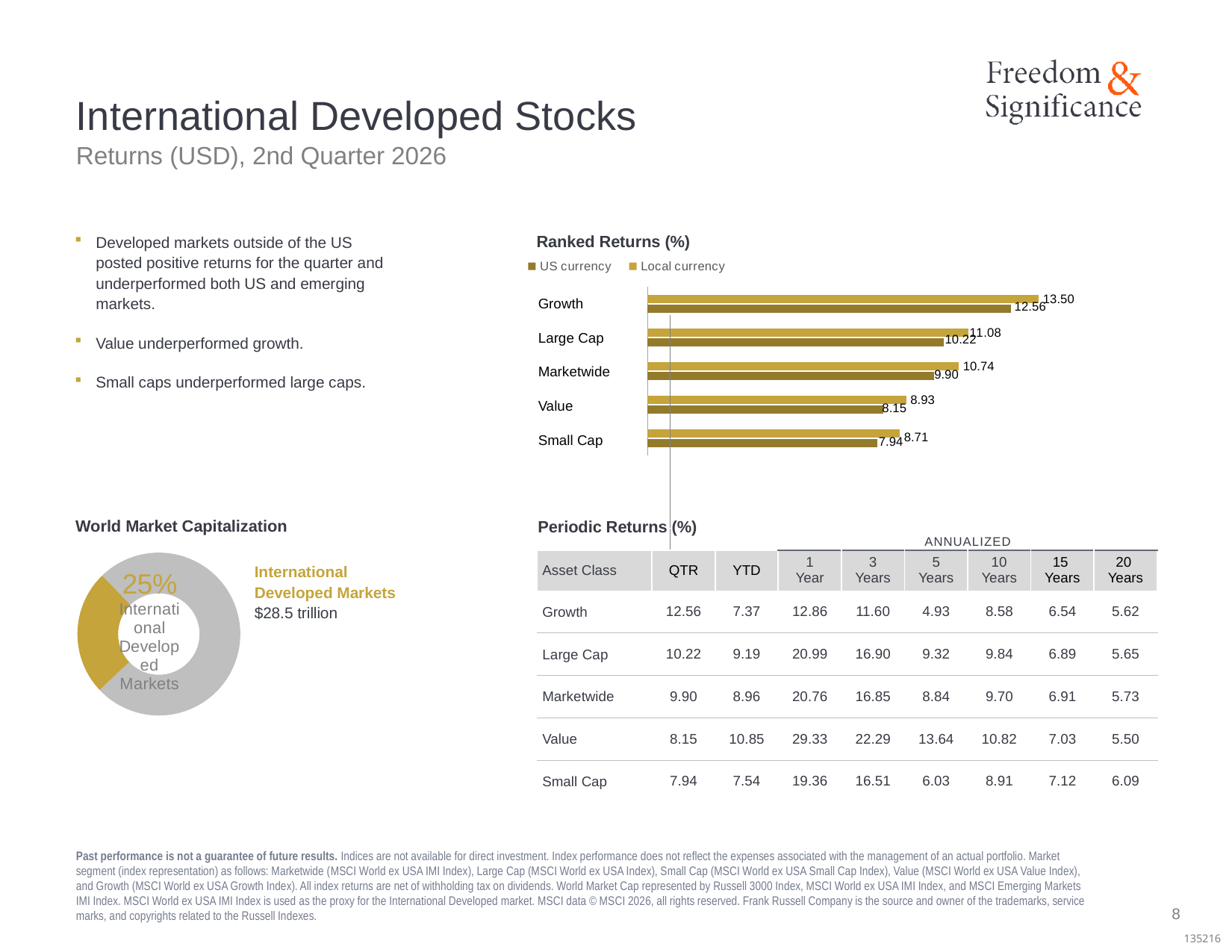
What kind of chart is the Ranked Returns (%) chart? Bar chart How many categories are shown in the Ranked Returns (%) chart? 5 In the Ranked Returns (%) chart, what is the Local currency value for Large Cap? 11.08 In the Ranked Returns (%) chart, which category has the lowest US currency value? Small Cap In the Ranked Returns (%) chart, which category has the highest Local currency value? Growth In the Ranked Returns (%) chart, what is the US currency value for Small Cap? 7.94 In the Ranked Returns (%) chart, which is larger: the US currency value for Large Cap or the US currency value for Marketwide? Large Cap In the World Market Capitalization chart, what share is labelled for International Developed Markets? 25% How many series does the legend of the Ranked Returns (%) chart list? 2 In the Ranked Returns (%) chart, what is the difference between the Local currency and US currency values for Value? 0.78 In the Ranked Returns (%) chart, what is the US currency value for Growth? 12.56 What kind of chart is the World Market Capitalization chart? Doughnut chart